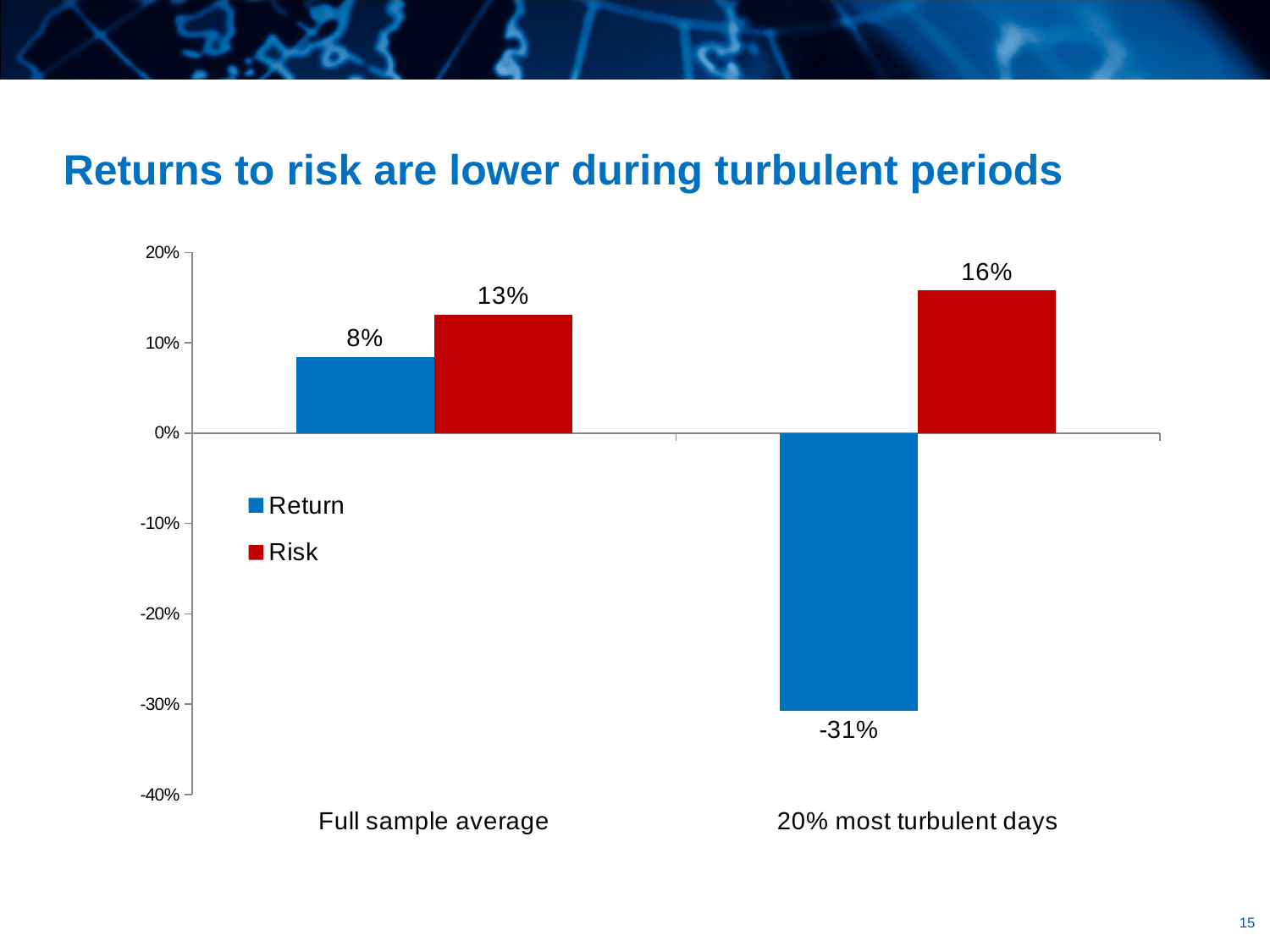
What kind of chart is shown on the slide? bar chart Which category has the lowest Return value? 20% most turbulent days Which category has the highest Risk value? 20% most turbulent days How many series does the legend list? 2 What is the Return value for 20% most turbulent days? -31% What is the Return value for Full sample average? 8% Is the Return value for 20% most turbulent days greater or less than -20%? less How many categories are shown on the x axis? 2 What is the Risk value for 20% most turbulent days? 16% Which is larger for Full sample average, Return or Risk? Risk What is the Risk value for Full sample average? 13% What is the difference between the Risk values for 20% most turbulent days and Full sample average? 3%